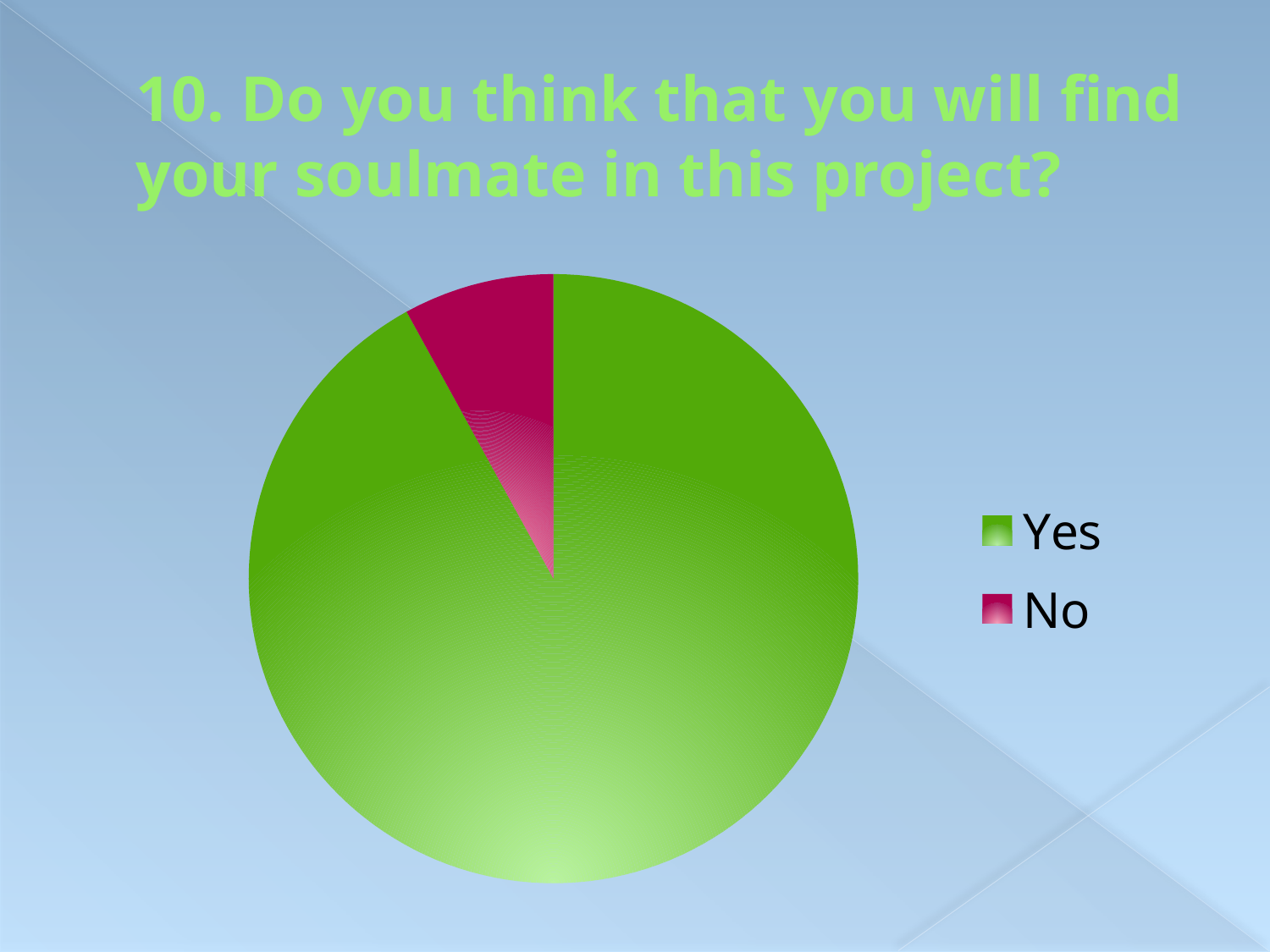
How many slices does the pie chart have? 2 How many entries does the legend list? 2 What colour is the Yes slice? green Which category has the largest slice of the pie? Yes What colour is the No slice? pink Which slice is larger, Yes or No? Yes What kind of chart is shown on the slide? pie chart Which category has the smallest slice of the pie? No